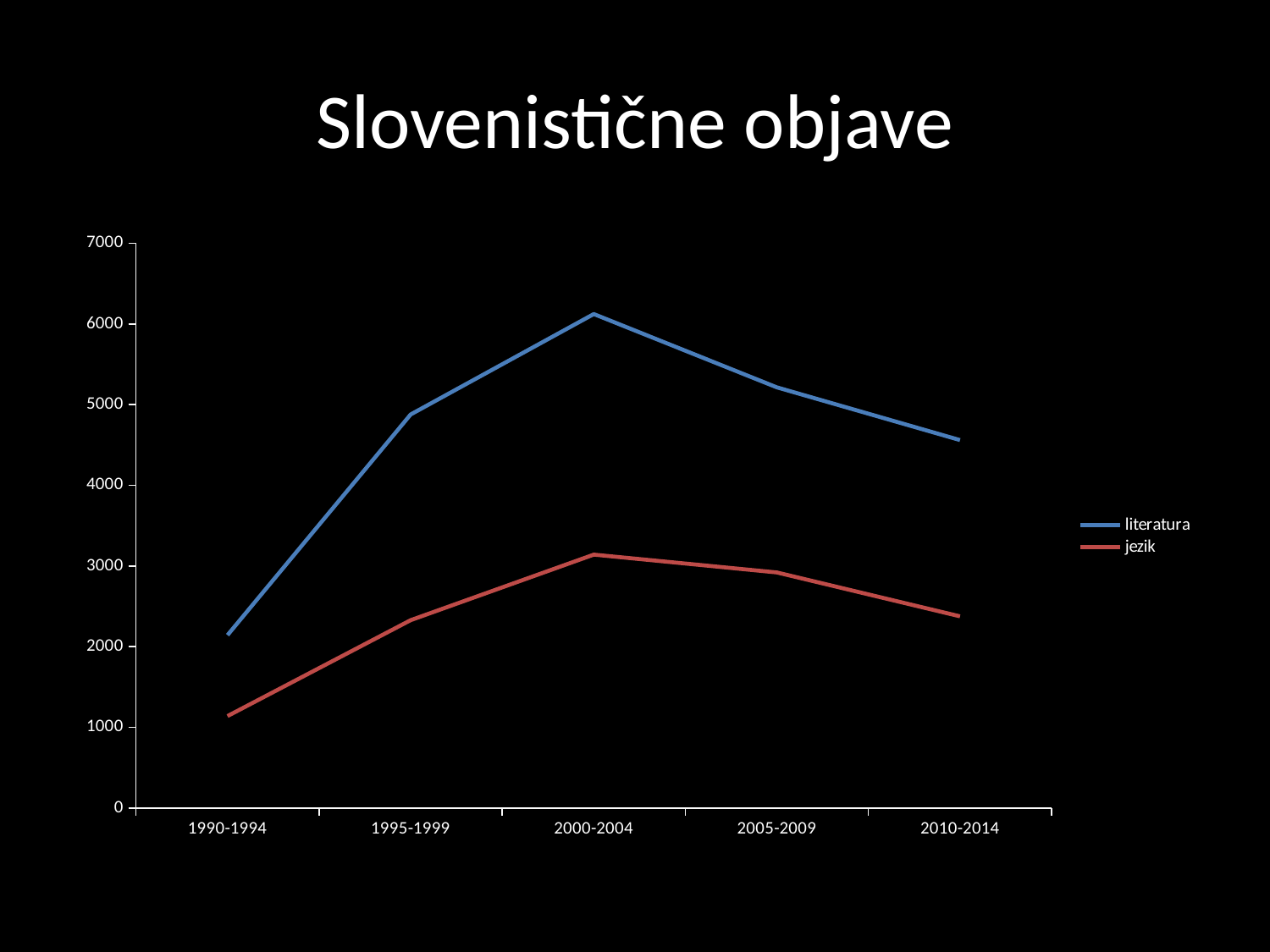
How many time periods are shown on the x axis? 5 Is the value for literatura in 2010-2014 greater or less than 5000? less How many series does the legend list? 2 In which period does the literatura series reach its highest value? 2000-2004 What is the title of the chart? Slovenistične objave Is the value for literatura in 1995-1999 greater or less than 4000? greater Which series is higher in 2005-2009, literatura or jezik? literatura What kind of chart is shown on the slide? line chart In which period does the jezik series have its lowest value? 1990-1994 Which colour is used for the jezik series? red Is the value for jezik in 2010-2014 greater or less than 3000? less Does the jezik series rise or fall between 1990-1994 and 2000-2004? rise